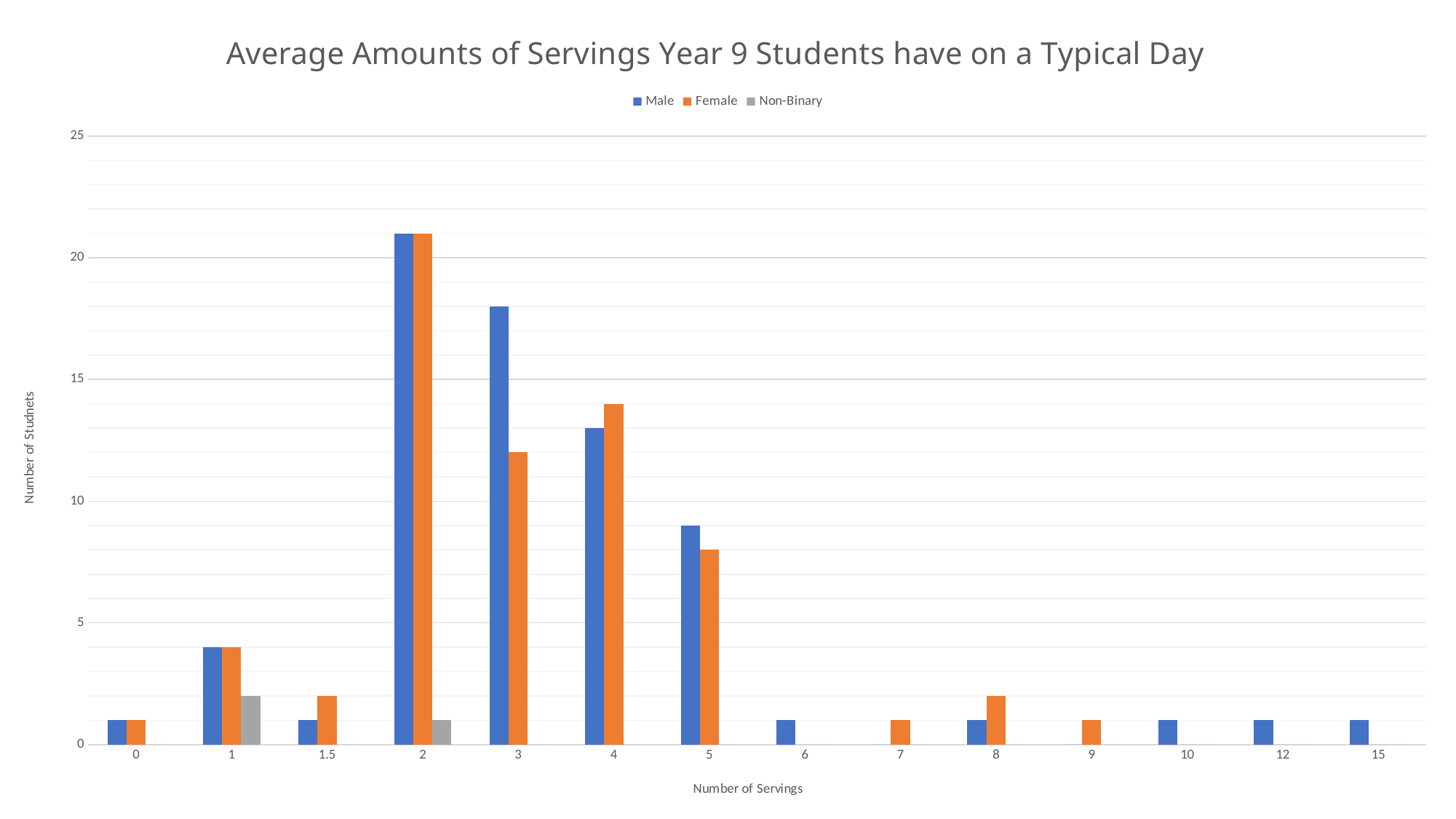
At which number of servings is the Non-Binary bar highest? 1 How many series does the legend list? 3 At 4 servings, which is larger, the Male bar or the Female bar? Female At 3 servings, which is larger, the Male bar or the Female bar? Male At which number of servings is the Male bar highest? 2 Is the Male value at 5 servings greater or less than 5? greater What is the label of the y axis? Number of Studnets How many categories are shown on the x axis? 14 At which number of servings is the Female bar highest? 2 Is the Male value at 3 servings greater or less than 15? greater Is the Female value at 3 servings greater or less than 10? greater What kind of chart is shown on the slide? bar chart